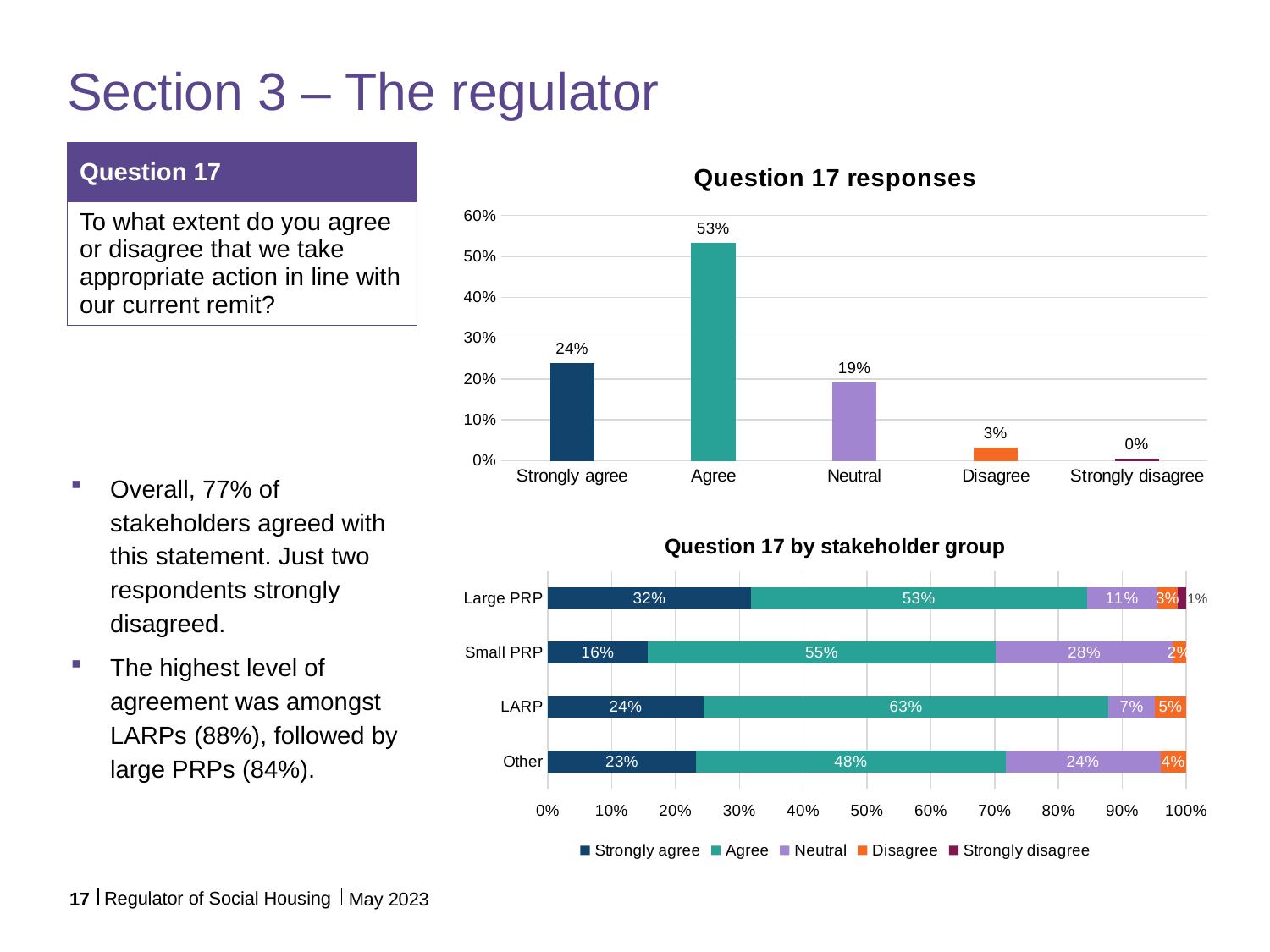
In the 'Question 17 responses' chart, which category has the lowest value? Strongly disagree In the 'Question 17 responses' chart, which category has the highest value? Agree In the 'Question 17 responses' chart, how many categories are shown on the x axis? 5 In the 'Question 17 by stakeholder group' chart, what is the difference between the Agree values for LARP and Other? 15% In the 'Question 17 responses' chart, what is the difference between Agree and Strongly agree? 29% In the 'Question 17 by stakeholder group' chart, which group has the larger Strongly agree value, Large PRP or Small PRP? Large PRP How many series does the legend of the 'Question 17 by stakeholder group' chart list? 5 In the 'Question 17 by stakeholder group' chart, what is the Neutral value for Small PRP? 28% What kind of chart is 'Question 17 responses'? Bar chart In the 'Question 17 responses' chart, what is the value for Disagree? 3% In the 'Question 17 by stakeholder group' chart, what is the Agree value for LARP? 63% In the 'Question 17 responses' chart, what is the value for Agree? 53%